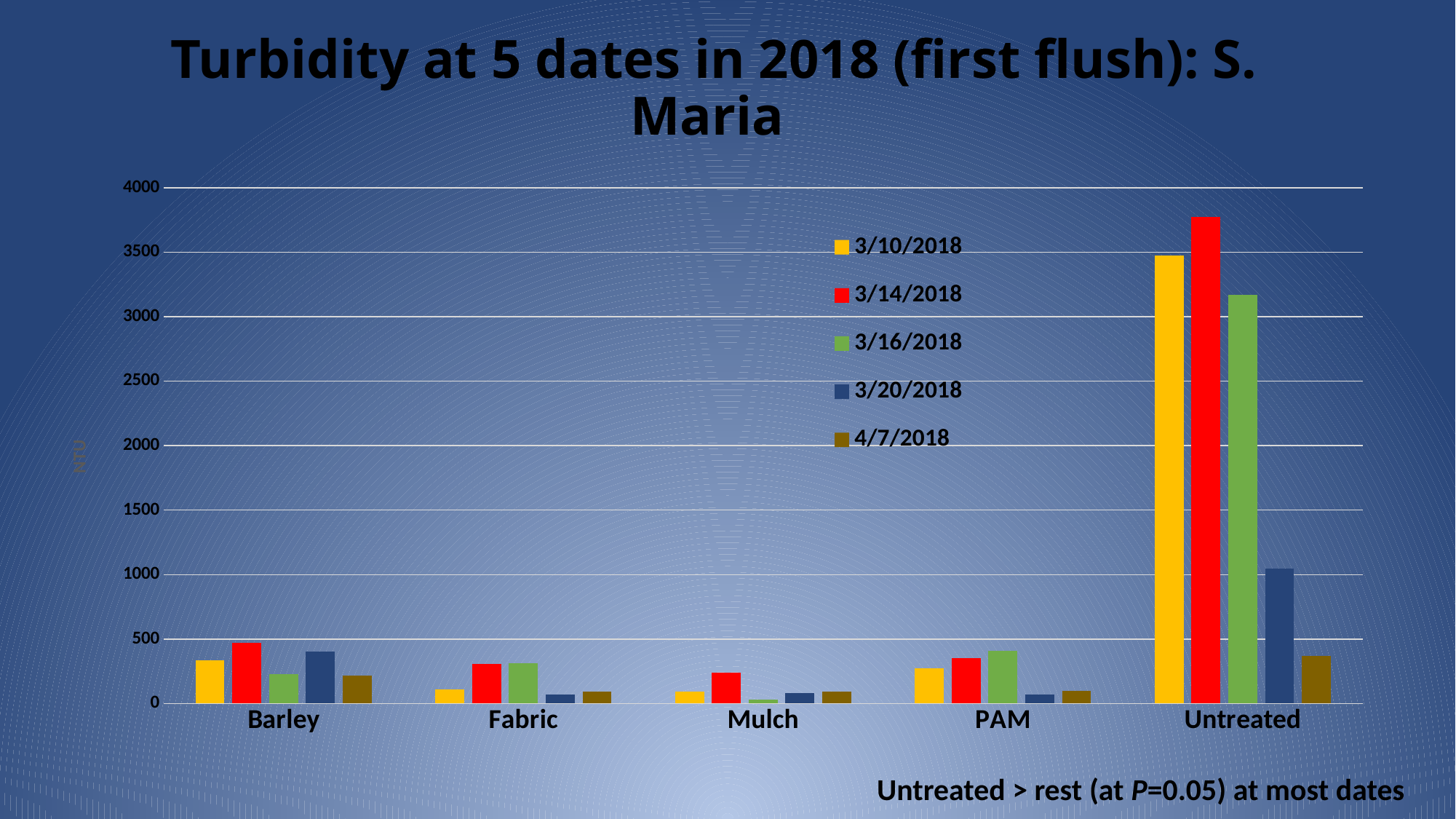
What kind of chart is shown on the slide? bar chart What is the title of the chart? Turbidity at 5 dates in 2018 (first flush): S. Maria Is the value for Barley on 3/14/2018 greater or less than 500? less Which category has the highest turbidity for 3/14/2018? Untreated How many series does the legend list? 5 For Untreated, which is larger: the value for 3/10/2018 or the value for 3/14/2018? 3/14/2018 Is the value for Untreated on 3/20/2018 greater or less than 1500? less How many treatment categories are shown on the x axis? 5 For Barley, which is larger: the value for 3/14/2018 or the value for 3/16/2018? 3/14/2018 Is the value for Untreated on 3/16/2018 greater or less than 3000? greater For Mulch, which date has the lowest turbidity? 3/16/2018